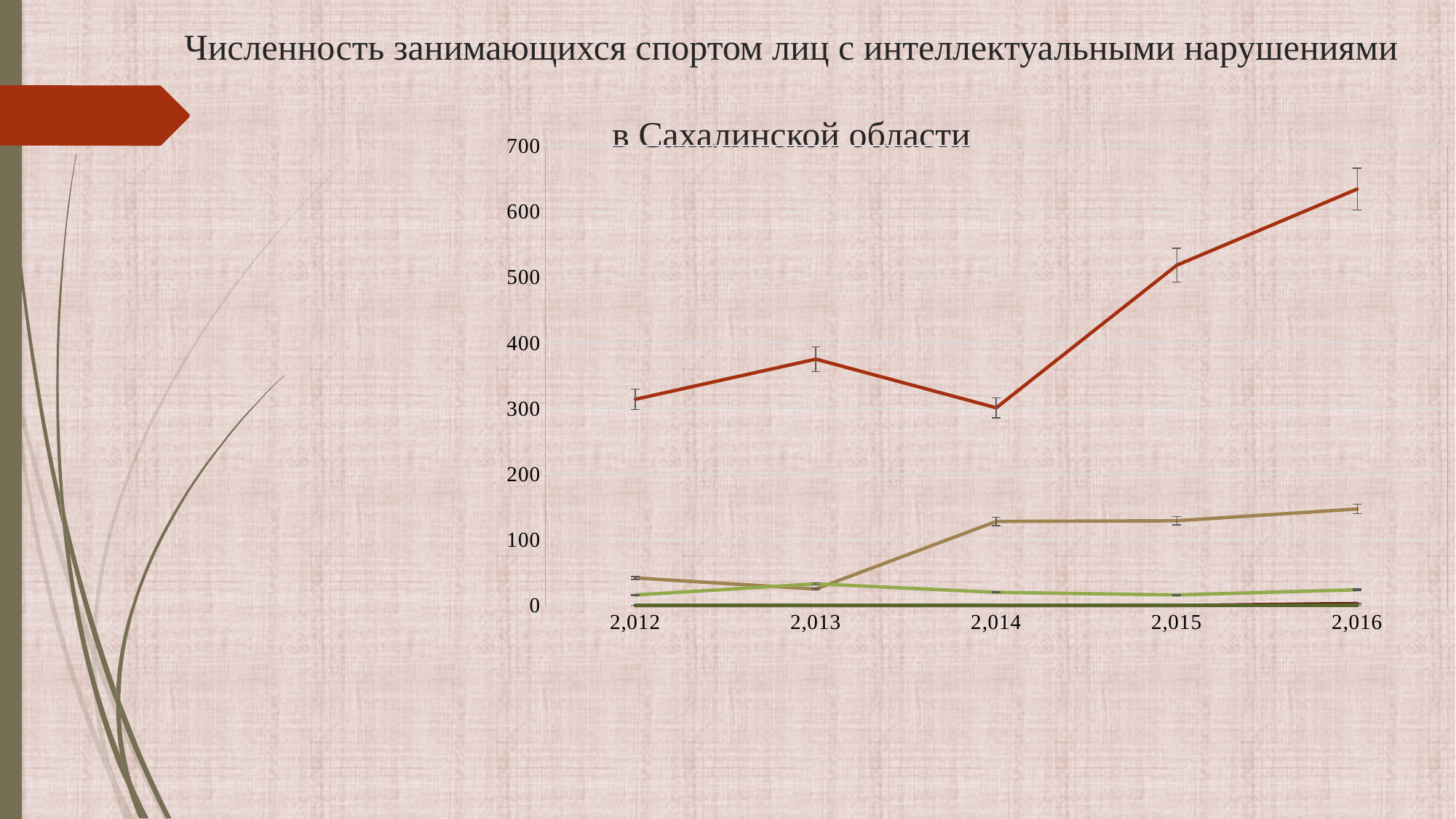
Is the value of the tan (brown) line for 2,016 greater or less than 100? greater What kind of chart is shown on the slide? line chart In which year does the red line reach its highest value? 2,016 Is the value of the tan (brown) line for 2,012 greater or less than 100? less What is the title of the chart? Численность занимающихся спортом лиц с интеллектуальными нарушениями в Сахалинской области Is the value of the red line for 2,015 greater or less than 500? greater How many years are shown along the x axis? 5 At 2,016, which line has the larger value, the red line or the tan (brown) line? the red line What is the highest tick value shown on the y axis? 700 Does the red line rise or fall from 2,014 to 2,016? rise